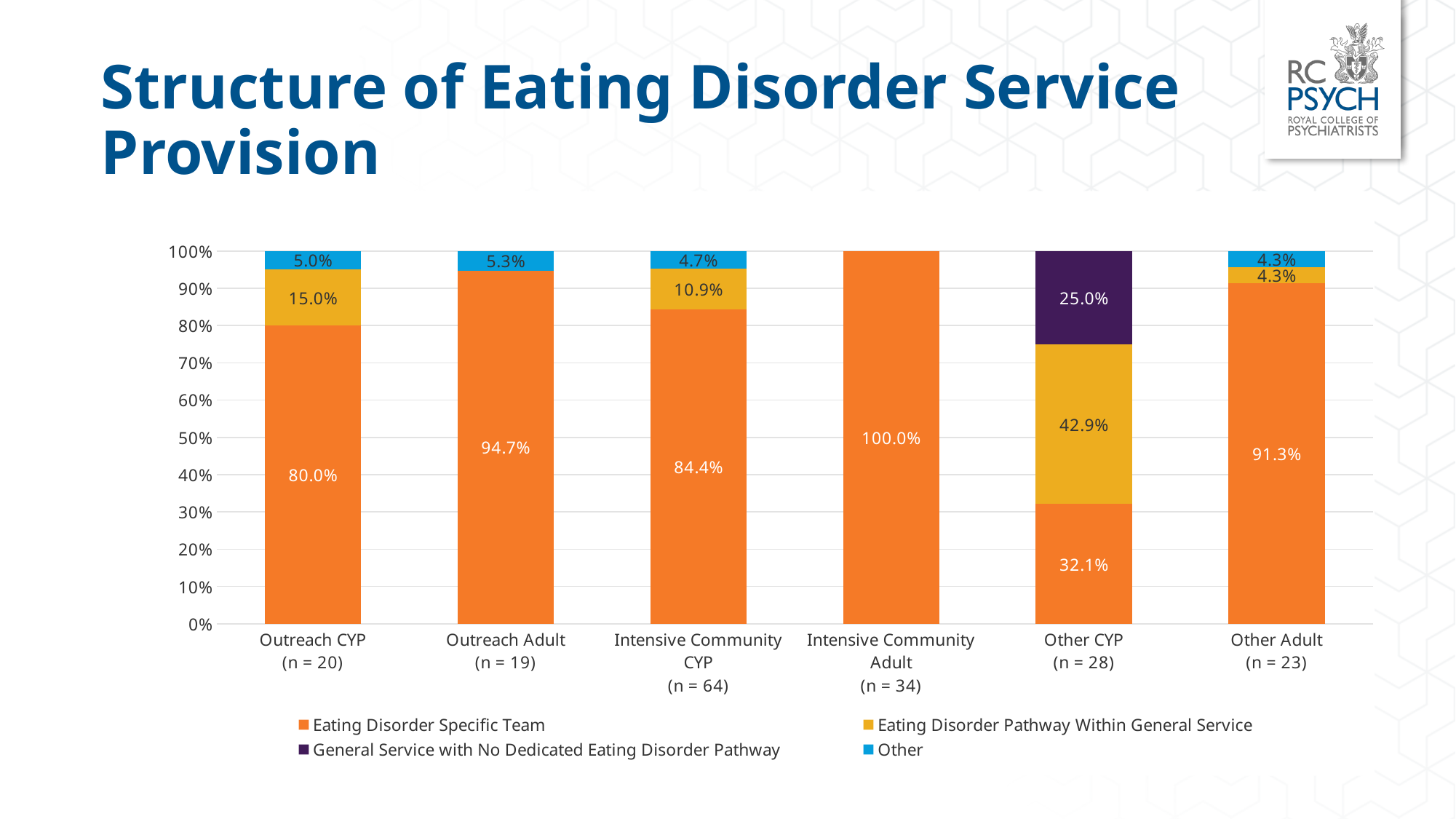
What is the Eating Disorder Specific Team value for Intensive Community Adult? 100.0% What is the sample size (n) shown for Intensive Community CYP? 64 Which is larger: the Eating Disorder Pathway Within General Service value for Other CYP or for Outreach CYP? Other CYP How many series does the legend list? 4 Which category has the lowest Eating Disorder Specific Team percentage? Other CYP How many categories are shown on the x axis? 6 What kind of chart is shown on the slide? Stacked bar chart What is the Eating Disorder Pathway Within General Service value for Intensive Community CYP? 10.9% Which category has the highest Eating Disorder Specific Team percentage? Intensive Community Adult What is the difference between the Eating Disorder Specific Team percentages for Outreach Adult and Outreach CYP? 14.7% What percentage of Other CYP services are a General Service with No Dedicated Eating Disorder Pathway? 25.0% What percentage of Outreach CYP services are an Eating Disorder Specific Team? 80.0%